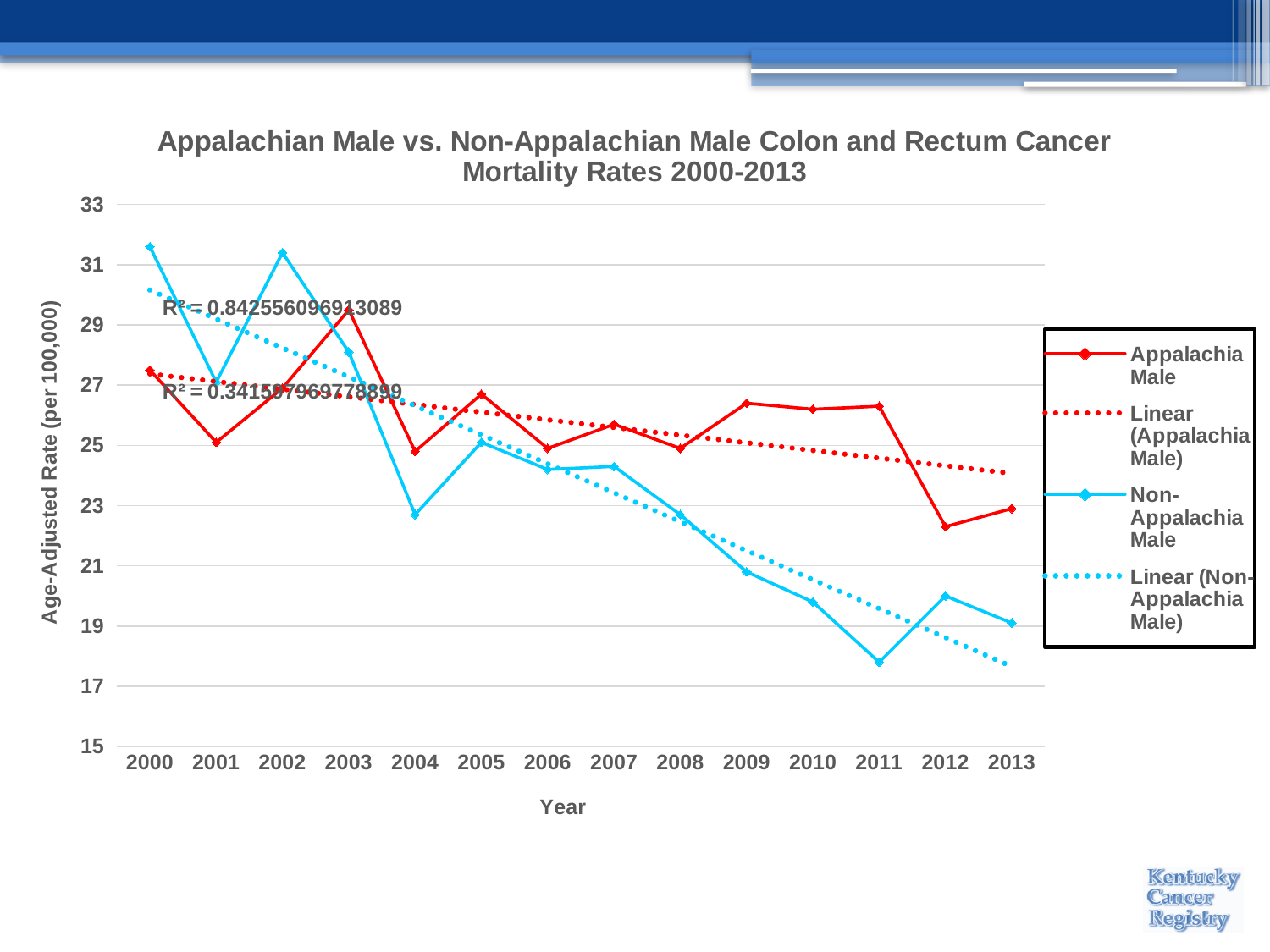
In 2013, which series has the higher rate, Appalachia Male or Non-Appalachia Male? Appalachia Male How many years are plotted along the x axis? 14 Is the Appalachia Male value for 2012 greater or less than 23? less Does the Non-Appalachia Male mortality rate generally rise or fall from 2000 to 2013? Fall In 2002, which series has the higher rate, Appalachia Male or Non-Appalachia Male? Non-Appalachia Male What kind of chart is shown on the slide? Line chart Is the Appalachia Male value for 2003 greater or less than 29? greater What is the title of the chart? Appalachian Male vs. Non-Appalachian Male Colon and Rectum Cancer Mortality Rates 2000-2013 How many entries does the legend list? 4 In which year is the Non-Appalachia Male rate lowest? 2011 In which year is the Appalachia Male rate highest? 2003 Is the Non-Appalachia Male value for 2011 greater or less than 19? less